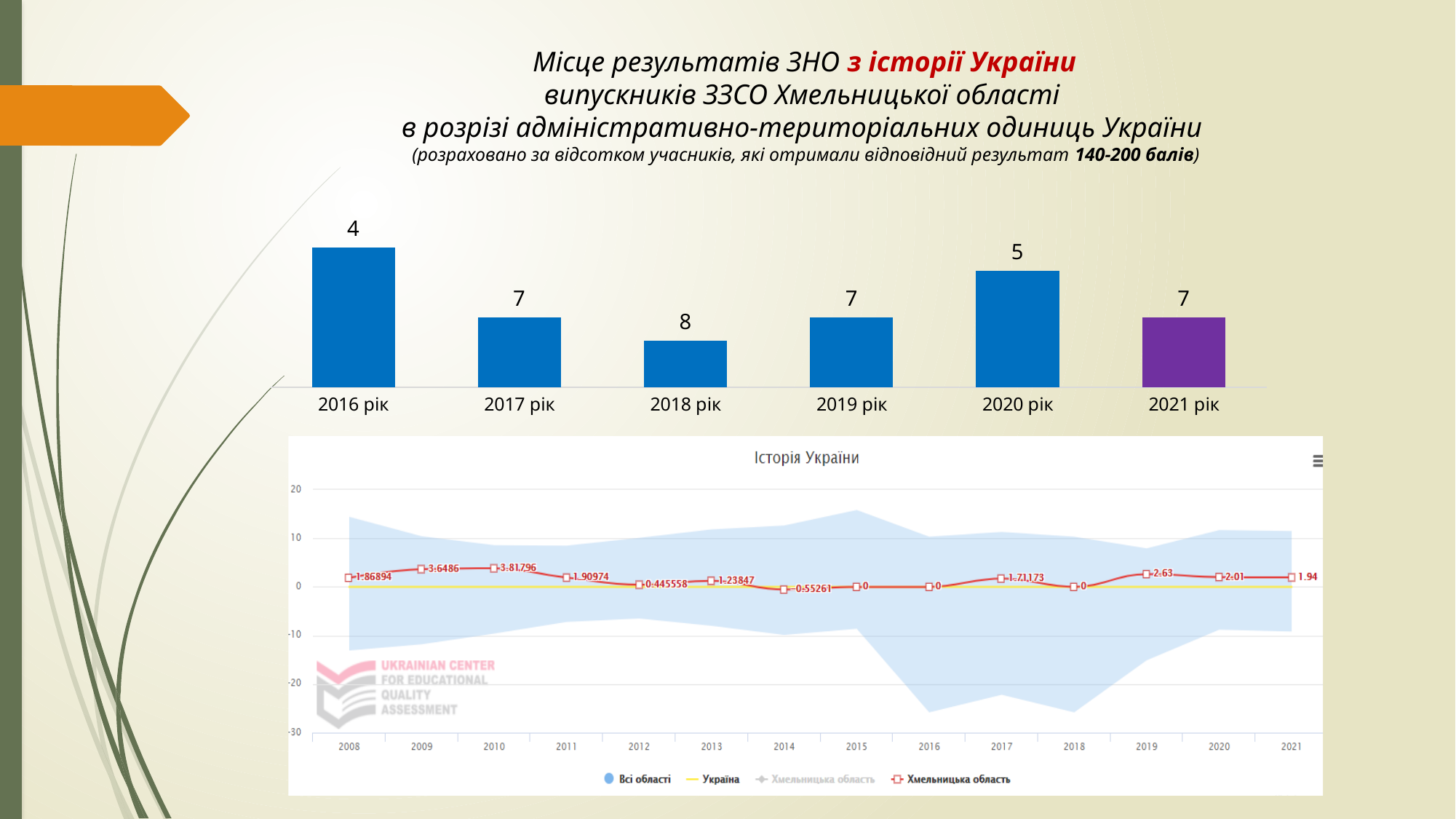
In the 'Історія України' chart, is the value for 2009 larger or smaller than the value for 2012? larger In the top bar chart, which bar is coloured differently from the others? 2021 рік In the 'Історія України' chart, what is the value for Хмельницька область in 2021? 1.94 In the top bar chart, what is the value for 2018 рік? 8 In the top bar chart, which year has the highest bar? 2016 рік In the top bar chart, what is the difference between the values for 2018 рік and 2020 рік? 3 In the top bar chart, how many years are shown? 6 In the 'Історія України' chart, what is the value for Хмельницька область in 2010? 3.81796 What kind of chart is the 'Історія України' chart? line chart In the top bar chart, which year has the lowest bar? 2018 рік In the top bar chart, what is the value for 2016 рік? 4 In the 'Історія України' chart, what is the value for Хмельницька область in 2019? 2.63